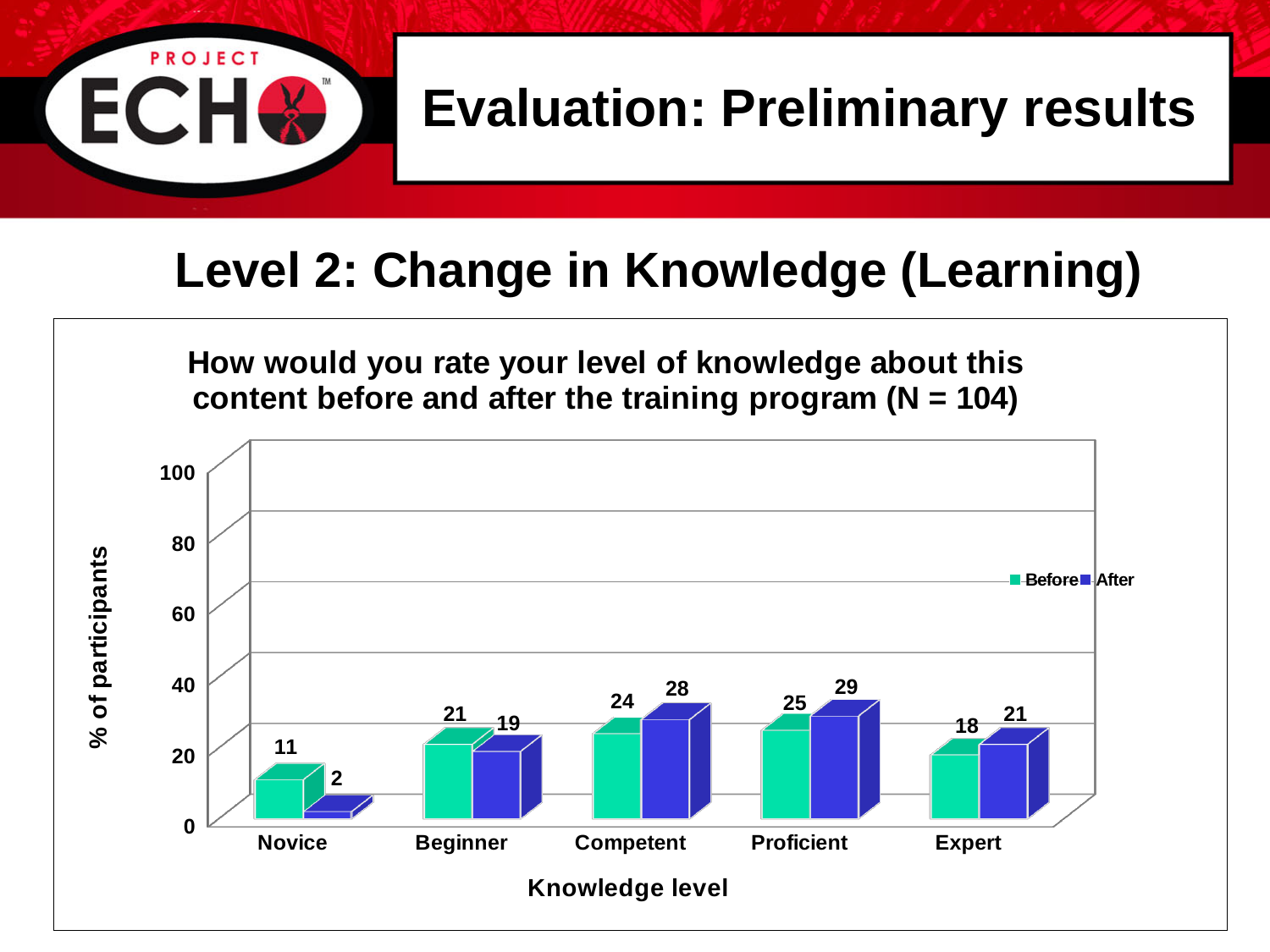
How many series does the legend list? 2 Which is larger for Competent, the Before value or the After value? After Is the Before value for Proficient greater or less than 20? greater Which knowledge level has the highest After value? Proficient How many knowledge levels are shown on the x axis? 5 What is the After value for Expert? 21 Which knowledge level has the lowest After value? Novice What is the difference between the Before and After values for Novice? 9 What is the Before value for Novice? 11 What is the label of the y axis? % of participants What kind of chart is shown? bar chart What is the After value for Proficient? 29